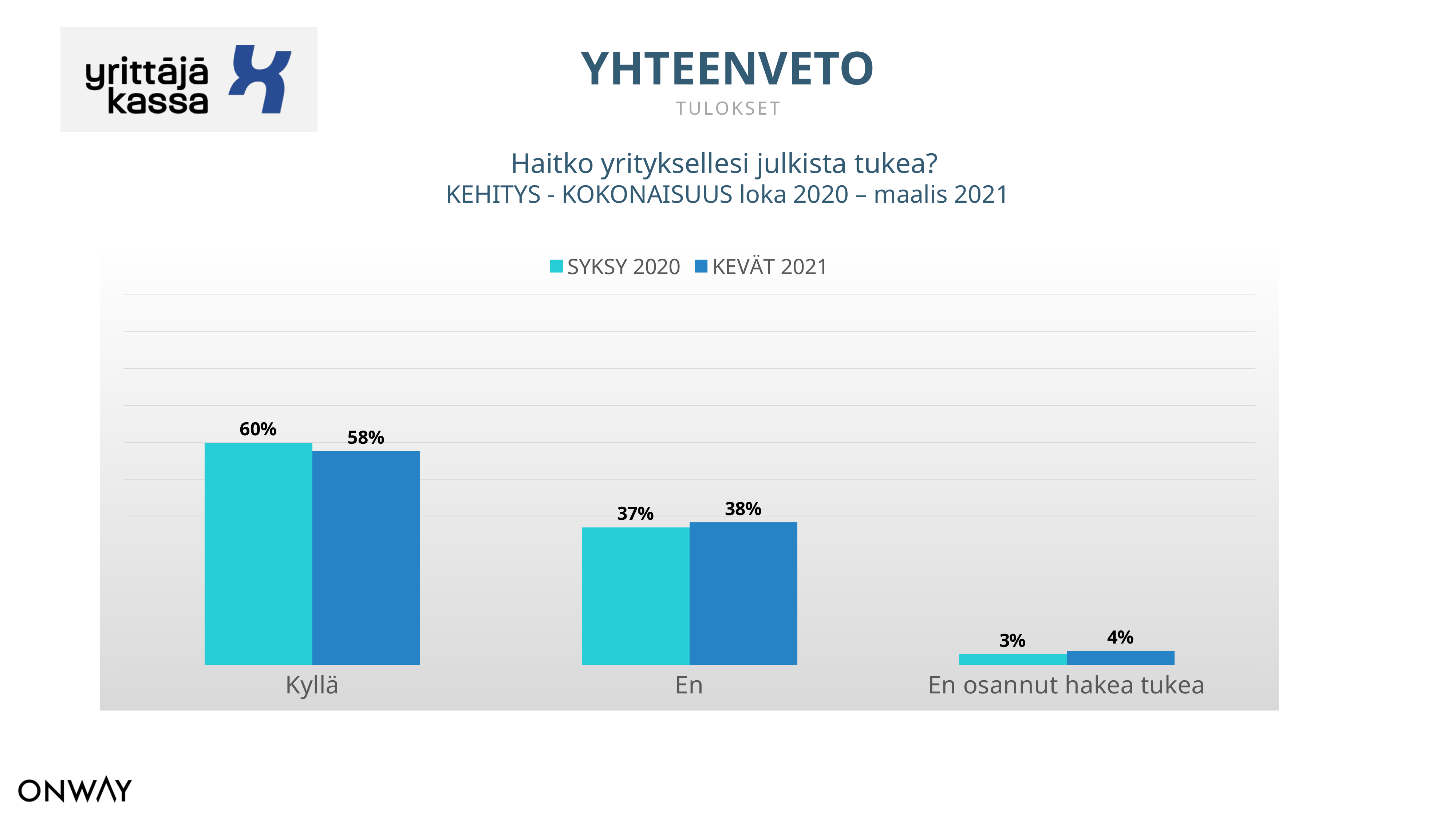
What is the difference between the SYKSY 2020 and KEVÄT 2021 values for Kyllä? 2% For En, which series has the larger value, SYKSY 2020 or KEVÄT 2021? KEVÄT 2021 What question does the chart title say the survey asked? Haitko yrityksellesi julkista tukea? What is the value for En in the SYKSY 2020 series? 37% Which category has the lowest value in the SYKSY 2020 series? En osannut hakea tukea What is the value for Kyllä in the KEVÄT 2021 series? 58% How many categories are shown on the x axis? 3 Which category has the highest value in the KEVÄT 2021 series? Kyllä What is the value for En osannut hakea tukea in the KEVÄT 2021 series? 4% What kind of chart is shown on the slide? Bar chart What is the value for Kyllä in the SYKSY 2020 series? 60% How many series does the legend list? 2